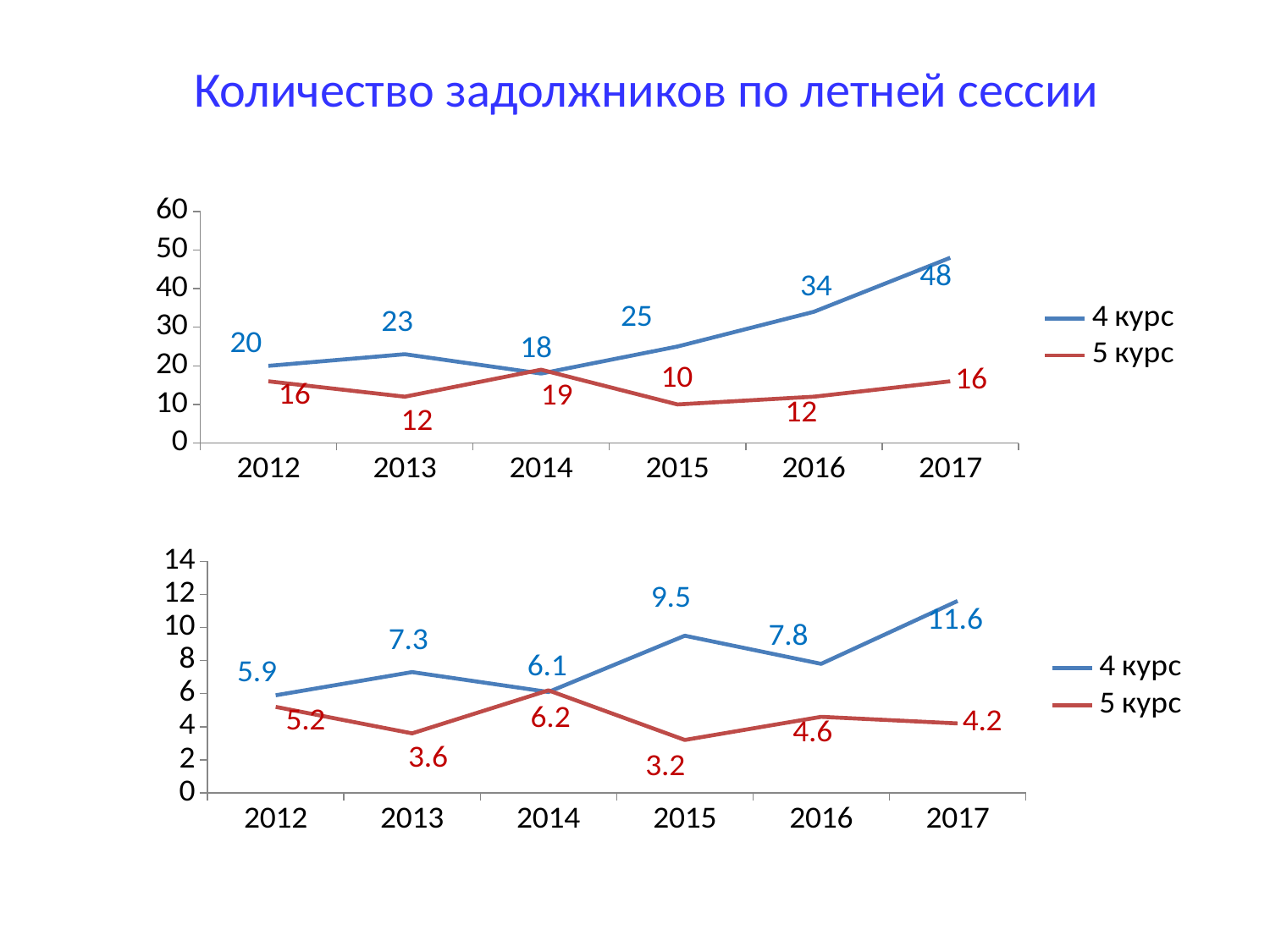
What type of chart is the top chart? Line chart In the top chart, which year has the lowest value for 5 курс? 2015 In the top chart, what is the value for 5 курс in 2015? 10 In the top chart, which series has the larger value in 2014, 4 курс or 5 курс? 5 курс In the bottom chart, what is the difference between 4 курс and 5 курс in 2017? 7.4 In the bottom chart, what is the value for 5 курс in 2013? 3.6 In the top chart, what is the value for 4 курс in 2017? 48 How many years are shown on the x axis of the bottom chart? 6 In the bottom chart, what is the value for 4 курс in 2015? 9.5 In the top chart, which year has the highest value for 4 курс? 2017 In the bottom chart, which year has the highest value for 4 курс? 2017 In the top chart, what is the difference between 4 курс and 5 курс in 2016? 22